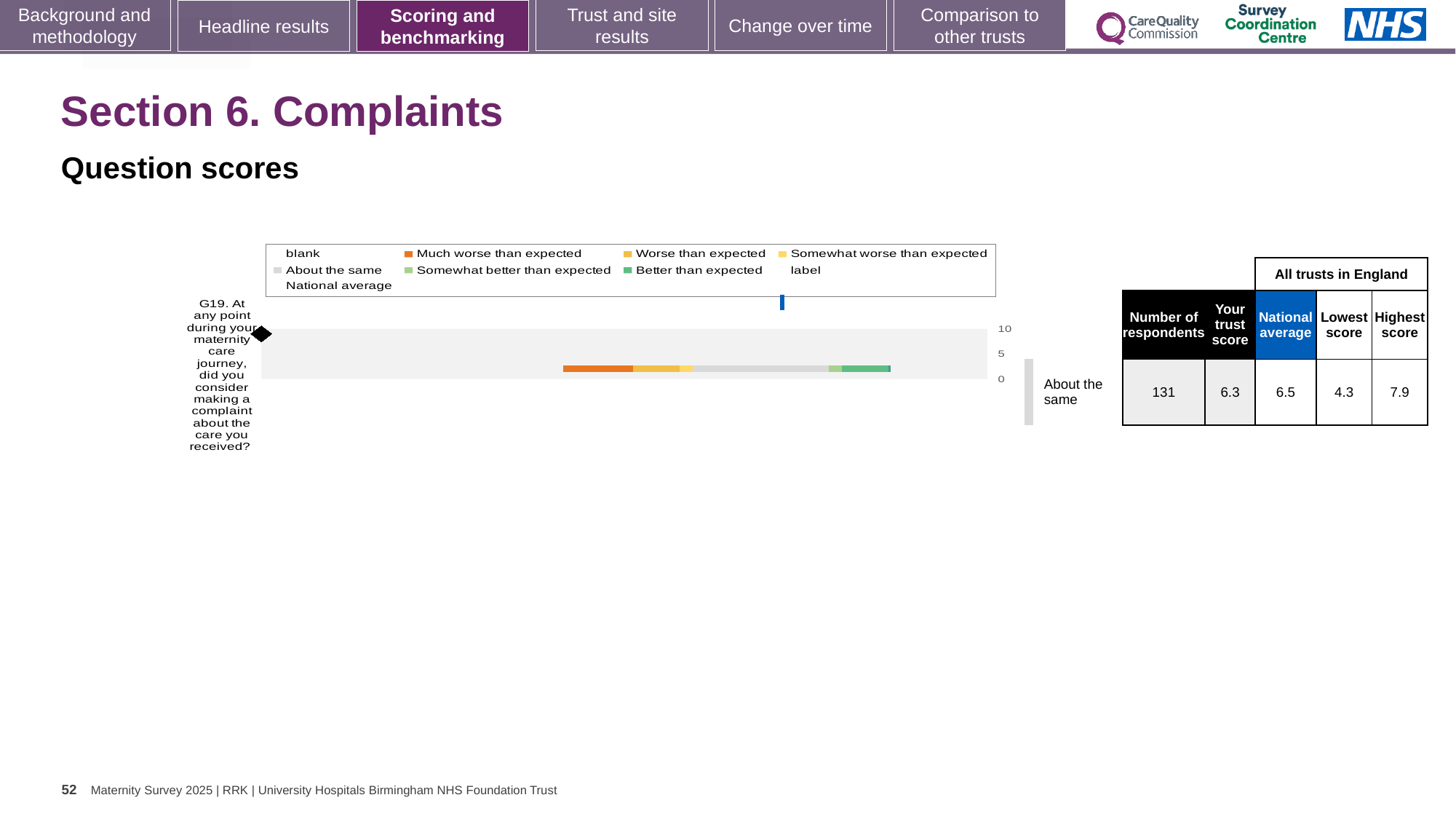
What is the national average score for question G19? 6.5 What is the number of respondents for question G19? 131 What kind of chart is shown on the slide? bar chart What is the trust score for question G19? 6.3 What is the difference between the highest score and the lowest score for question G19? 3.6 What benchmark category is shown next to the chart for question G19? About the same What colour represents 'Much worse than expected' in the chart legend? orange What is the lowest score among all trusts in England for question G19? 4.3 What is the highest score among all trusts in England for question G19? 7.9 Which question number is plotted in the chart? G19 How many questions (categories) are plotted in the chart? 1 Which is larger for question G19, the trust score or the national average? national average